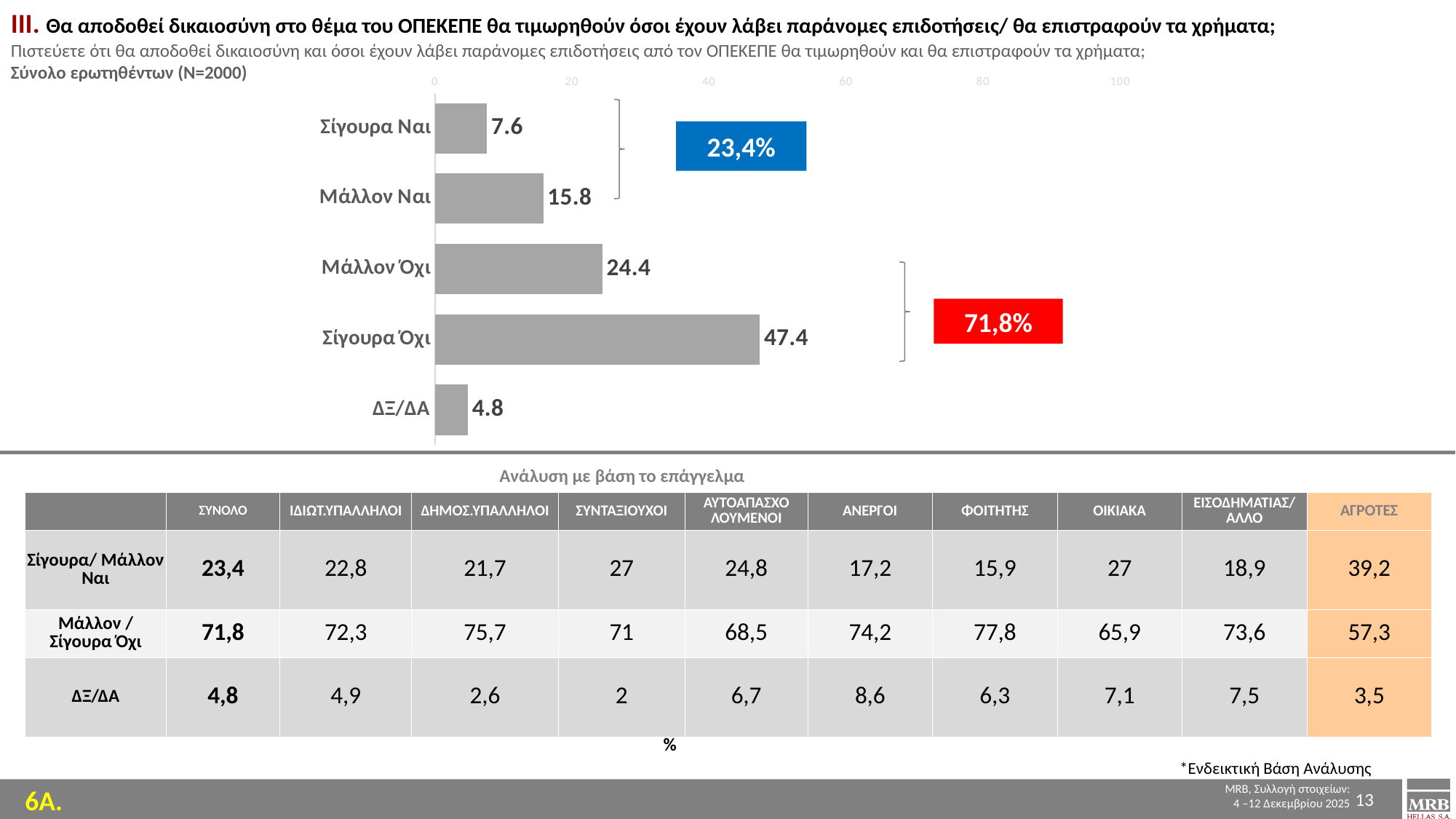
What is the combined total of Σίγουρα Ναι and Μάλλον Ναι? 23.4 What is the value for Μάλλον Ναι? 15.8 Is the value for Σίγουρα Όχι greater or less than 40? greater What percentage is shown in the red callout box next to the chart? 71,8% What is the value for Σίγουρα Όχι? 47.4 Which is larger, the value for Μάλλον Ναι or the value for Σίγουρα Ναι? Μάλλον Ναι Which category has the lowest value? ΔΞ/ΔΑ What is the value for ΔΞ/ΔΑ? 4.8 Which category has the highest value? Σίγουρα Όχι How many categories are shown in the bar chart? 5 What kind of chart is shown on the slide? bar chart What is the difference between the values for Σίγουρα Όχι and Μάλλον Όχι? 23.0